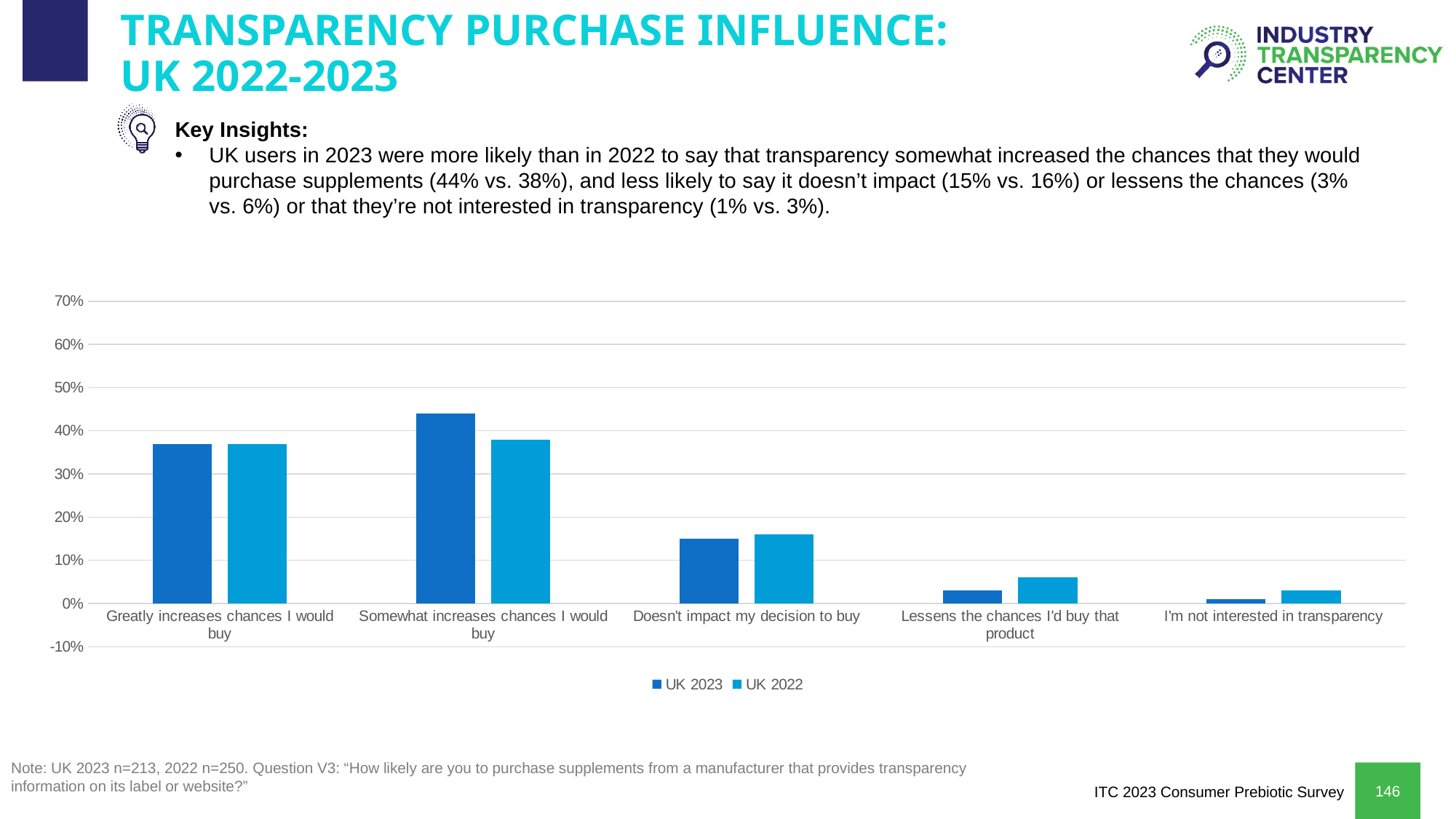
How many categories are shown on the x axis? 5 Is the UK 2022 value for 'Somewhat increases chances I would buy' greater or less than 40%? less Which category has the lowest value for UK 2023? I'm not interested in transparency For 'Somewhat increases chances I would buy', which series has the larger value, UK 2023 or UK 2022? UK 2023 Which category has the highest value for UK 2023? Somewhat increases chances I would buy What are the two series named in the legend? UK 2023 and UK 2022 According to the slide, what is the UK 2023 value for 'Somewhat increases chances I would buy'? 44% How many series does the legend list? 2 Is the UK 2023 value for 'Doesn't impact my decision to buy' greater or less than 20%? less Is the UK 2023 value for 'Greatly increases chances I would buy' greater or less than 30%? greater For 'Lessens the chances I'd buy that product', which series has the larger value, UK 2023 or UK 2022? UK 2022 What kind of chart is shown on the slide? bar chart